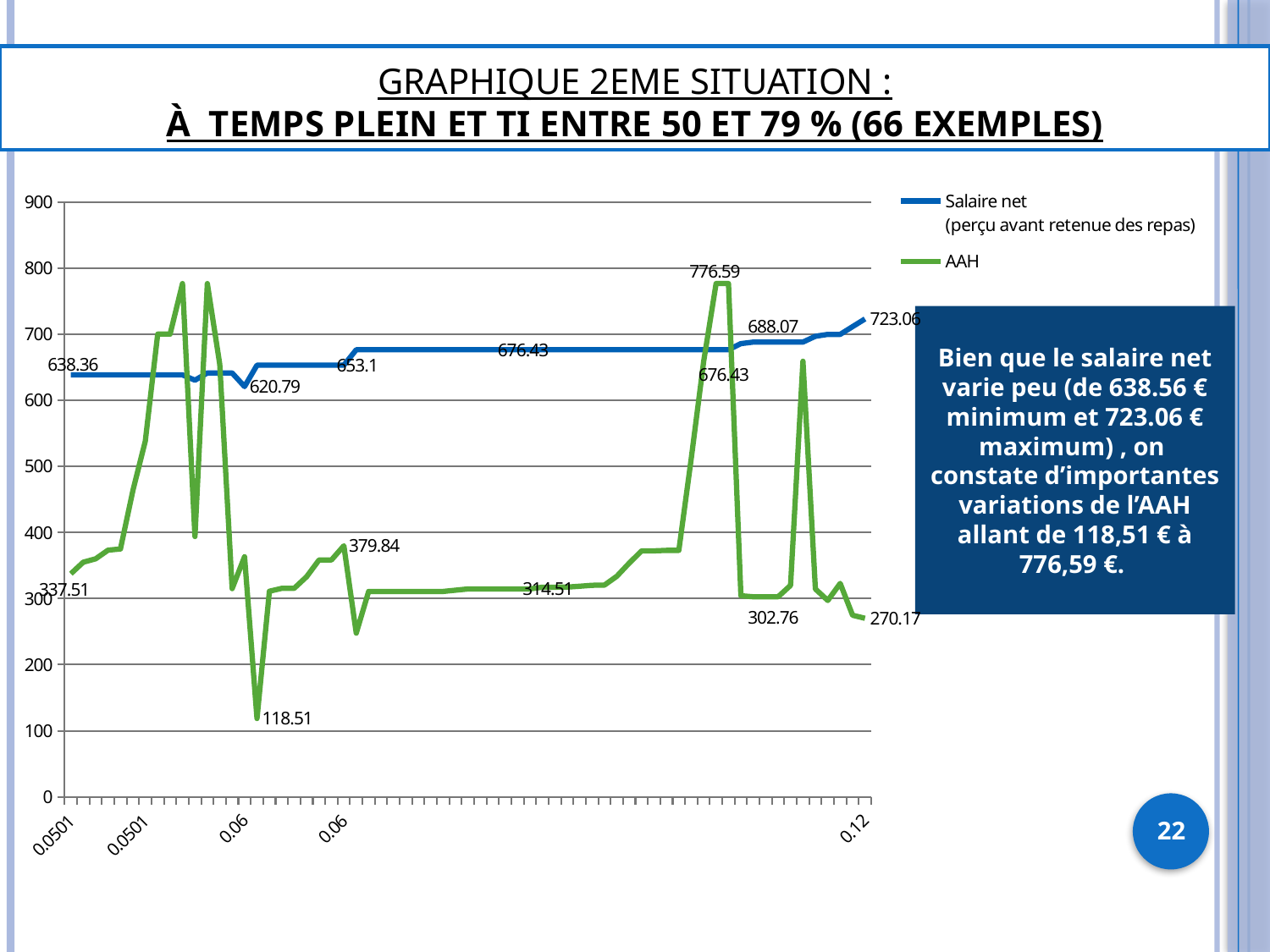
Which two series are listed in the legend? Salaire net (perçu avant retenue des repas) and AAH What is the difference between the highest labelled AAH value (776.59) and the lowest labelled AAH value (118.51)? 658.08 What is the value labelled at the right end of the Salaire net line? 723.06 What is the value labelled at the left end of the Salaire net line? 638.36 What is the highest labelled value on the AAH line? 776.59 At the right end of the chart, which series has the higher value, Salaire net or AAH? Salaire net What is the value labelled at the right end of the AAH line? 270.17 Is the lowest point of the Salaire net line greater or less than 600? greater What is the lowest labelled value on the AAH line? 118.51 How many series does the legend list? 2 What kind of chart is shown on the slide? line chart Does the Salaire net line generally rise or fall from left to right? rise